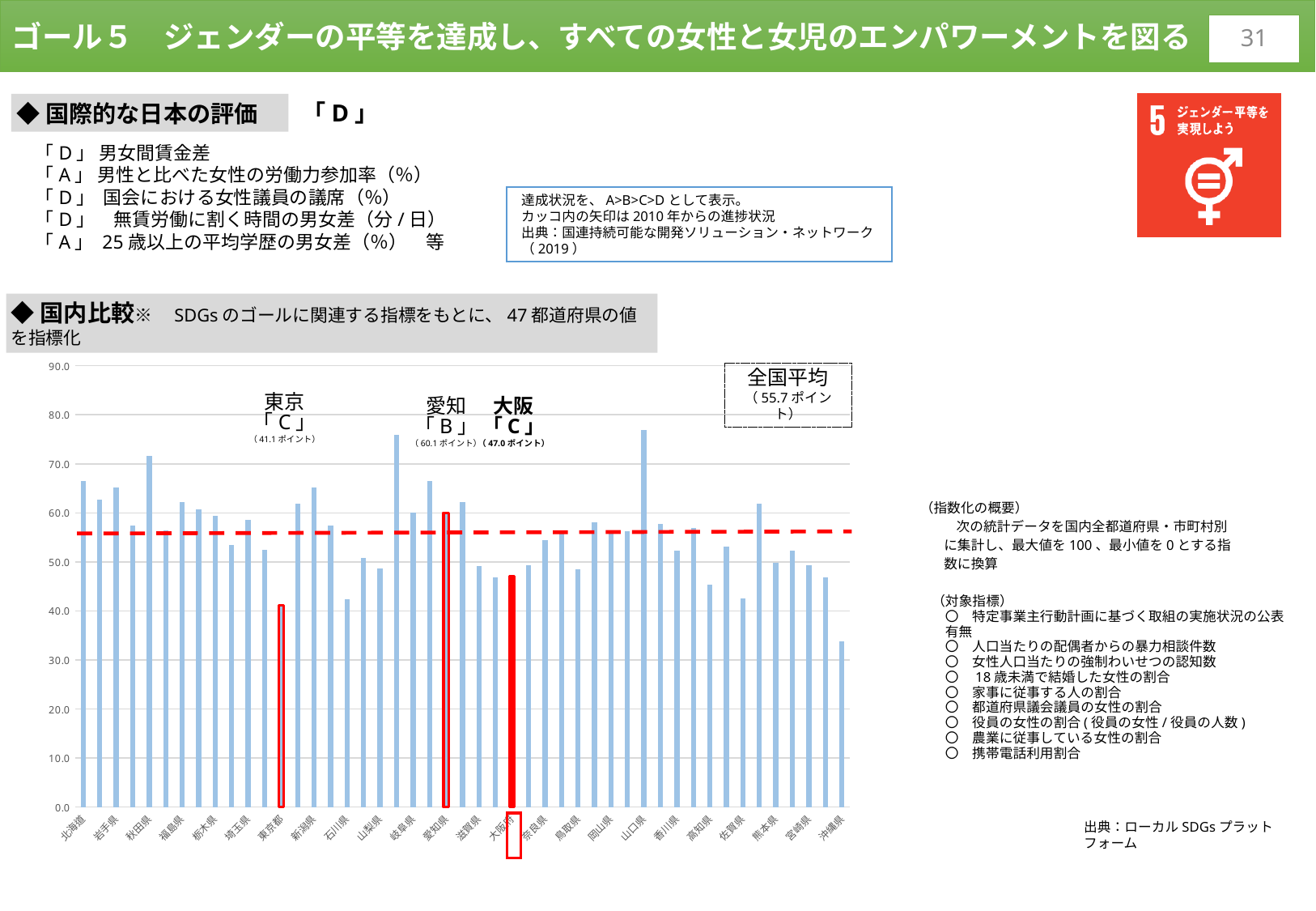
What is the difference between the printed values for 愛知 and 東京? 19.0 ポイント Is the value for 沖縄県 greater or less than 40.0? less What is the difference between the printed values for 愛知 and 大阪? 13.1 ポイント Which has the larger value, 東京 or 大阪? 大阪 In the bar chart, what value is printed for 大阪? 47.0 ポイント Is the value for 愛知 greater or less than the 全国平均? greater In the bar chart, what value is printed for 愛知? 60.1 ポイント In the bar chart, what value is printed for 東京? 41.1 ポイント Is the value for 山口県 greater or less than 70.0? greater What kind of chart is used for the 国内比較 section? bar chart Which prefecture has the lowest bar in the chart? 沖縄県 What is the 全国平均 value shown on the chart? 55.7 ポイント